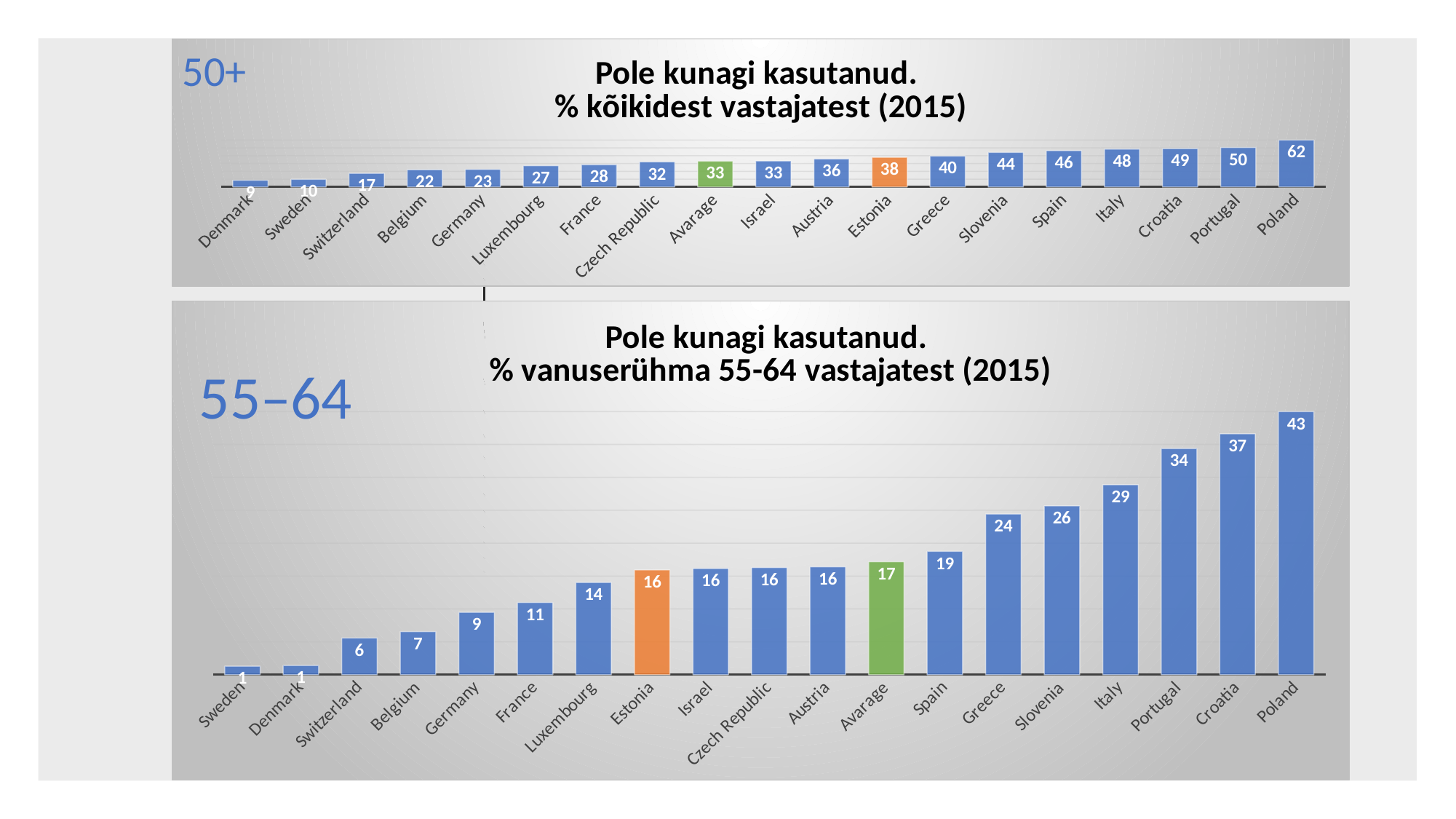
In the top chart (50+), how many bars are plotted? 19 In the bottom chart (55–64), which is larger, Croatia or Portugal? Croatia In the bottom chart (55–64), which country has the highest value? Poland In the bottom chart (55–64), do the values rise or fall from left to right? Rise In the top chart (50+), which country has the lowest value? Denmark In the bottom chart (55–64), what is the value for Estonia? 16 In the bottom chart (55–64), what is the difference between Poland and Greece? 19 What kind of chart is the bottom chart (55–64)? Bar chart In the top chart (50+), which country has the highest value? Poland In the bottom chart (55–64), what is the value for Avarage? 17 In the top chart (50+), what is the difference between Poland and Portugal? 12 In the top chart (50+), what is the value for Estonia? 38